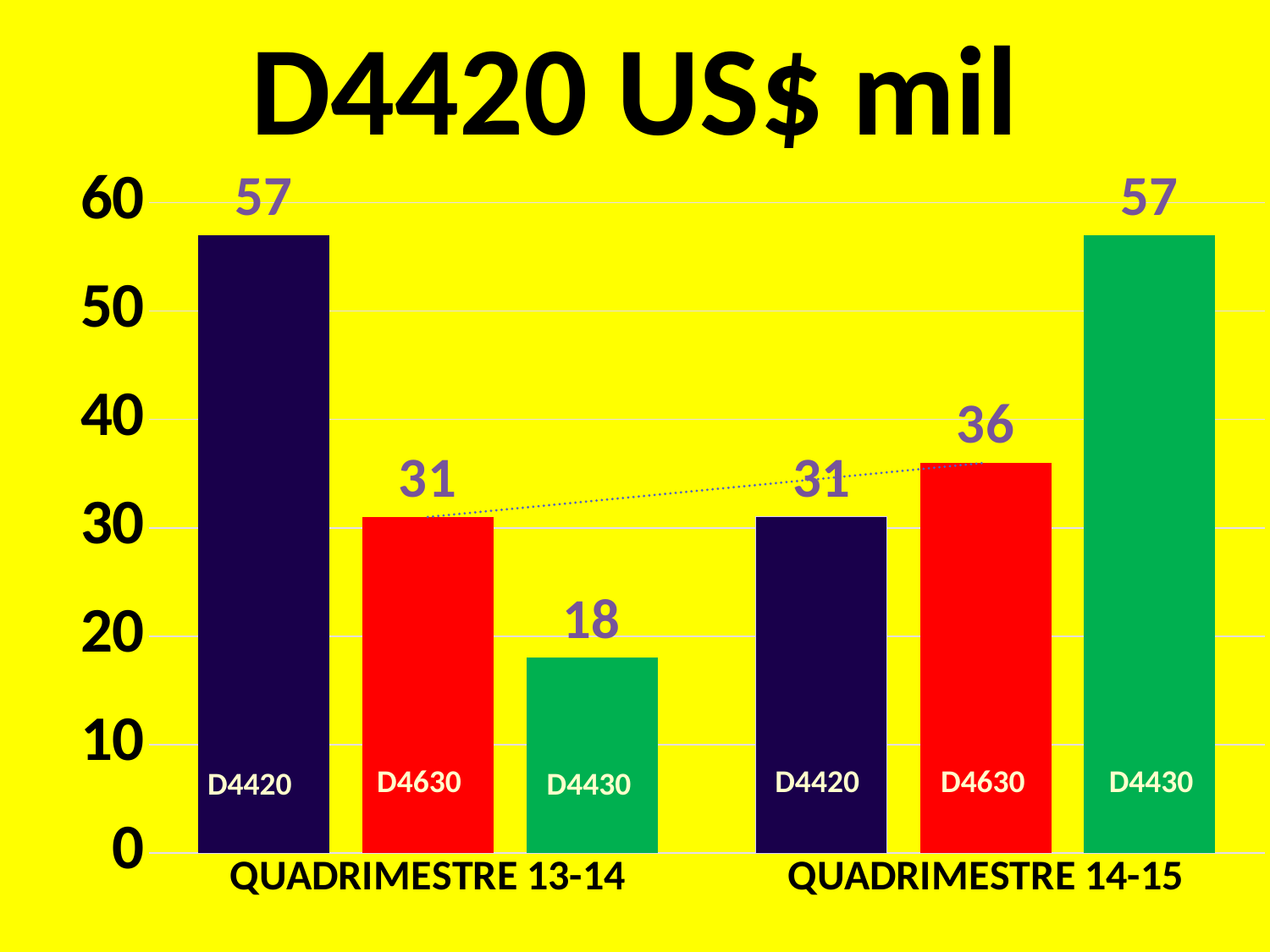
What is the value for D4430 in QUADRIMESTRE 13-14? 18 How many categories are shown on the x axis? 2 What is the difference between the D4630 values in QUADRIMESTRE 14-15 and QUADRIMESTRE 13-14? 5 What is the value for D4430 in QUADRIMESTRE 14-15? 57 What is the difference between D4420 and D4430 in QUADRIMESTRE 13-14? 39 What is the value for D4420 in QUADRIMESTRE 13-14? 57 What is the value for D4630 in QUADRIMESTRE 14-15? 36 Which series has the lowest value in QUADRIMESTRE 13-14? D4430 Which is larger: D4420 in QUADRIMESTRE 13-14 or D4420 in QUADRIMESTRE 14-15? D4420 in QUADRIMESTRE 13-14 Which series has the highest value in QUADRIMESTRE 14-15? D4430 What is the title of the chart? D4420 US$ mil What kind of chart is shown on the slide? bar chart